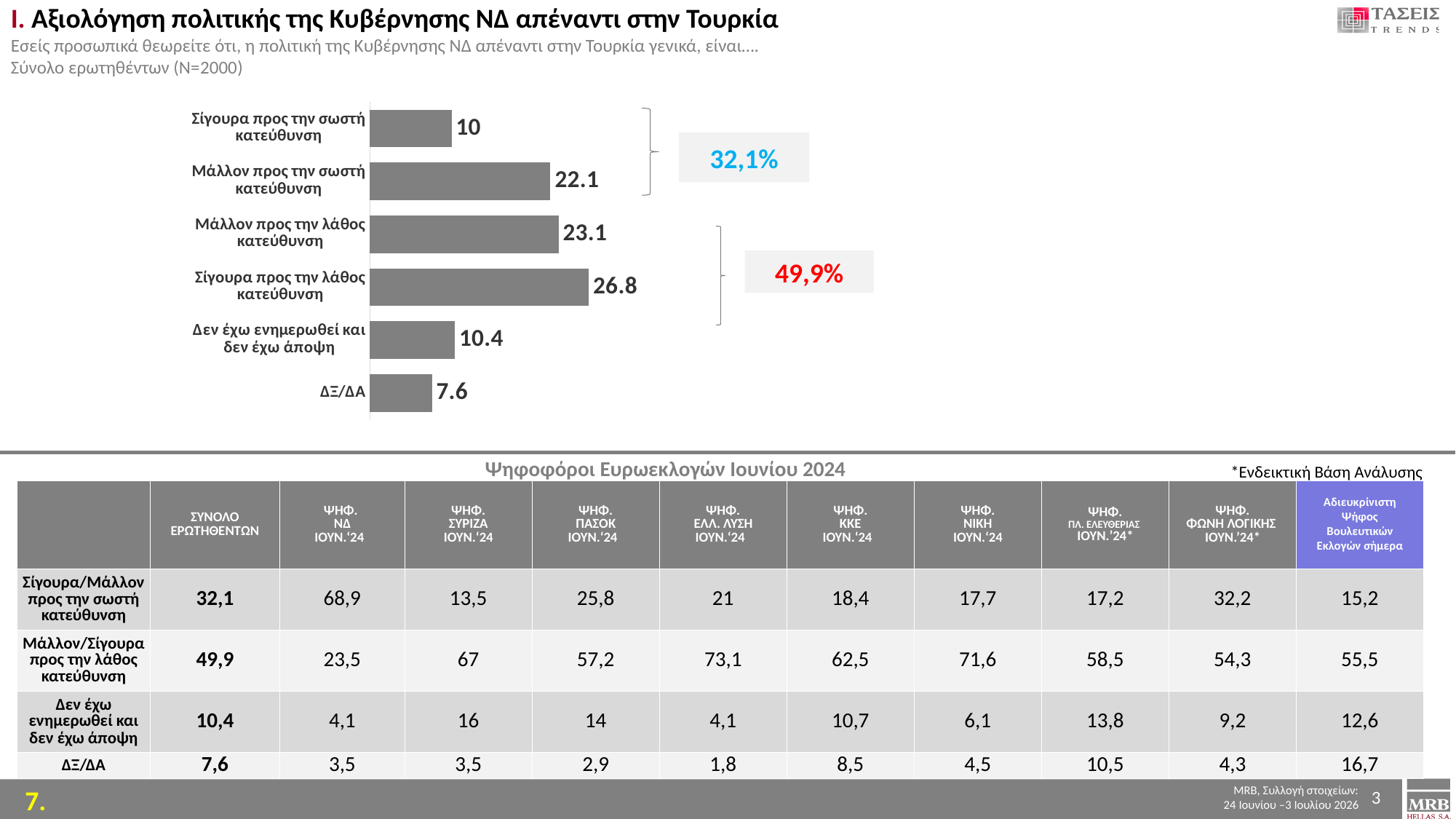
What value is shown for "Σίγουρα προς την σωστή κατεύθυνση" in the bar chart? 10 What is the combined total of "Σίγουρα προς την σωστή κατεύθυνση" and "Μάλλον προς την σωστή κατεύθυνση" in the bar chart? 32.1 What value is shown for "Σίγουρα προς την λάθος κατεύθυνση" in the bar chart? 26.8 Which category has the highest value in the bar chart? Σίγουρα προς την λάθος κατεύθυνση Which is larger in the bar chart: the value for "Μάλλον προς την σωστή κατεύθυνση" or the value for "Μάλλον προς την λάθος κατεύθυνση"? Μάλλον προς την λάθος κατεύθυνση What percentage is shown in red next to the bracket grouping the two "λάθος κατεύθυνση" bars? 49,9% What kind of chart is shown on the slide? Bar chart What is the difference between the values for "Σίγουρα προς την λάθος κατεύθυνση" and "Μάλλον προς την λάθος κατεύθυνση" in the bar chart? 3.7 How many categories are plotted in the bar chart? 6 What value is shown for "Μάλλον προς την σωστή κατεύθυνση" in the bar chart? 22.1 Which category has the lowest value in the bar chart? ΔΞ/ΔΑ What value is shown for "ΔΞ/ΔΑ" in the bar chart? 7.6